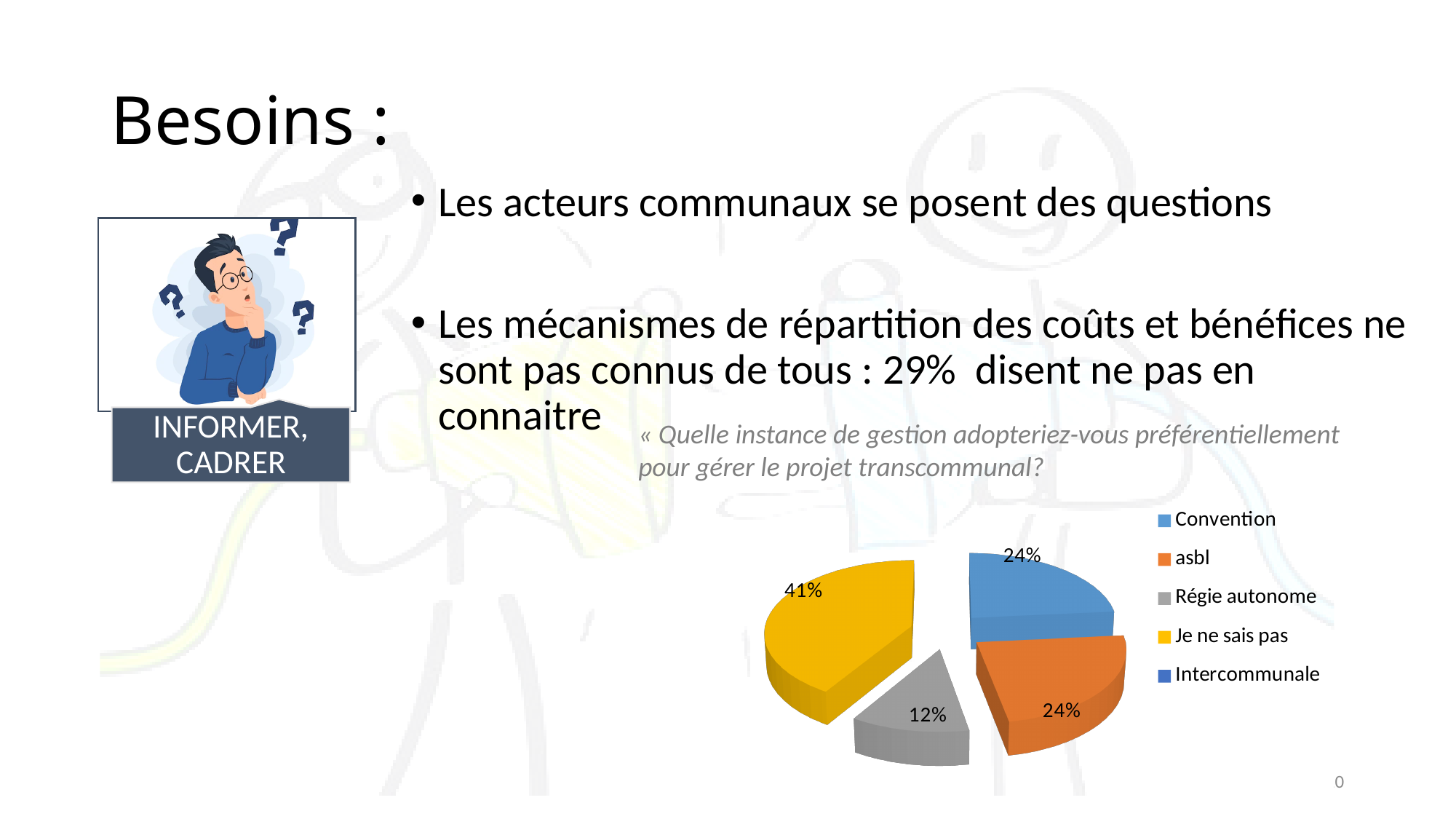
What percentage of the pie chart corresponds to "Je ne sais pas"? 41% How many entries does the legend of the pie chart list? 5 What is the difference in percentage points between the "Je ne sais pas" slice and the "Régie autonome" slice? 29 percentage points What percentage of the pie chart corresponds to "Régie autonome"? 12% Which of the labelled slices in the pie chart is the smallest? Régie autonome Which slice is larger in the pie chart: "Je ne sais pas" or "asbl"? Je ne sais pas What percentage of the pie chart corresponds to "Convention"? 24% What type of chart is shown on the slide? Pie chart What percentage of the pie chart corresponds to "asbl"? 24% What is the difference in percentage points between the "Je ne sais pas" slice and the "Convention" slice? 17 percentage points Which category has the largest slice in the pie chart? Je ne sais pas What colour is the "Je ne sais pas" slice in the pie chart? Yellow